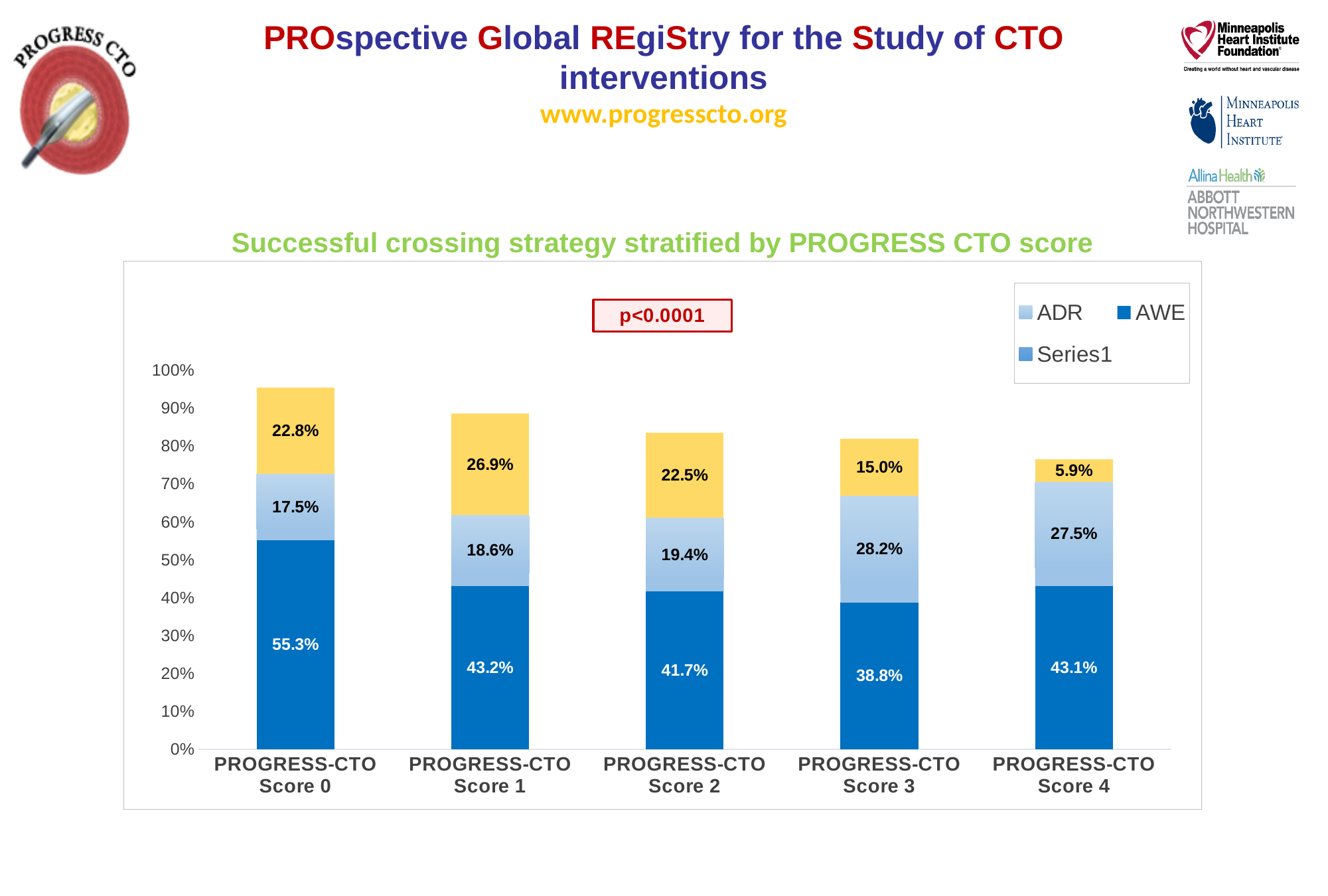
What is the ADR value for PROGRESS-CTO Score 3? 28.2% What is the difference between the AWE values for PROGRESS-CTO Score 0 and PROGRESS-CTO Score 1? 12.1% What is the value of the yellow top segment for PROGRESS-CTO Score 1? 26.9% What is the AWE value for PROGRESS-CTO Score 0? 55.3% What is the total of the stacked bar for PROGRESS-CTO Score 4? 76.5% Which PROGRESS-CTO score category has the lowest AWE value? PROGRESS-CTO Score 3 Which PROGRESS-CTO score category has the highest AWE value? PROGRESS-CTO Score 0 How many entries does the legend list? 3 Is the ADR value larger for PROGRESS-CTO Score 3 or PROGRESS-CTO Score 2? PROGRESS-CTO Score 3 What kind of chart is shown on the slide? Stacked bar chart Which PROGRESS-CTO score category has the smallest yellow top segment? PROGRESS-CTO Score 4 How many PROGRESS-CTO score categories are shown on the x axis? 5